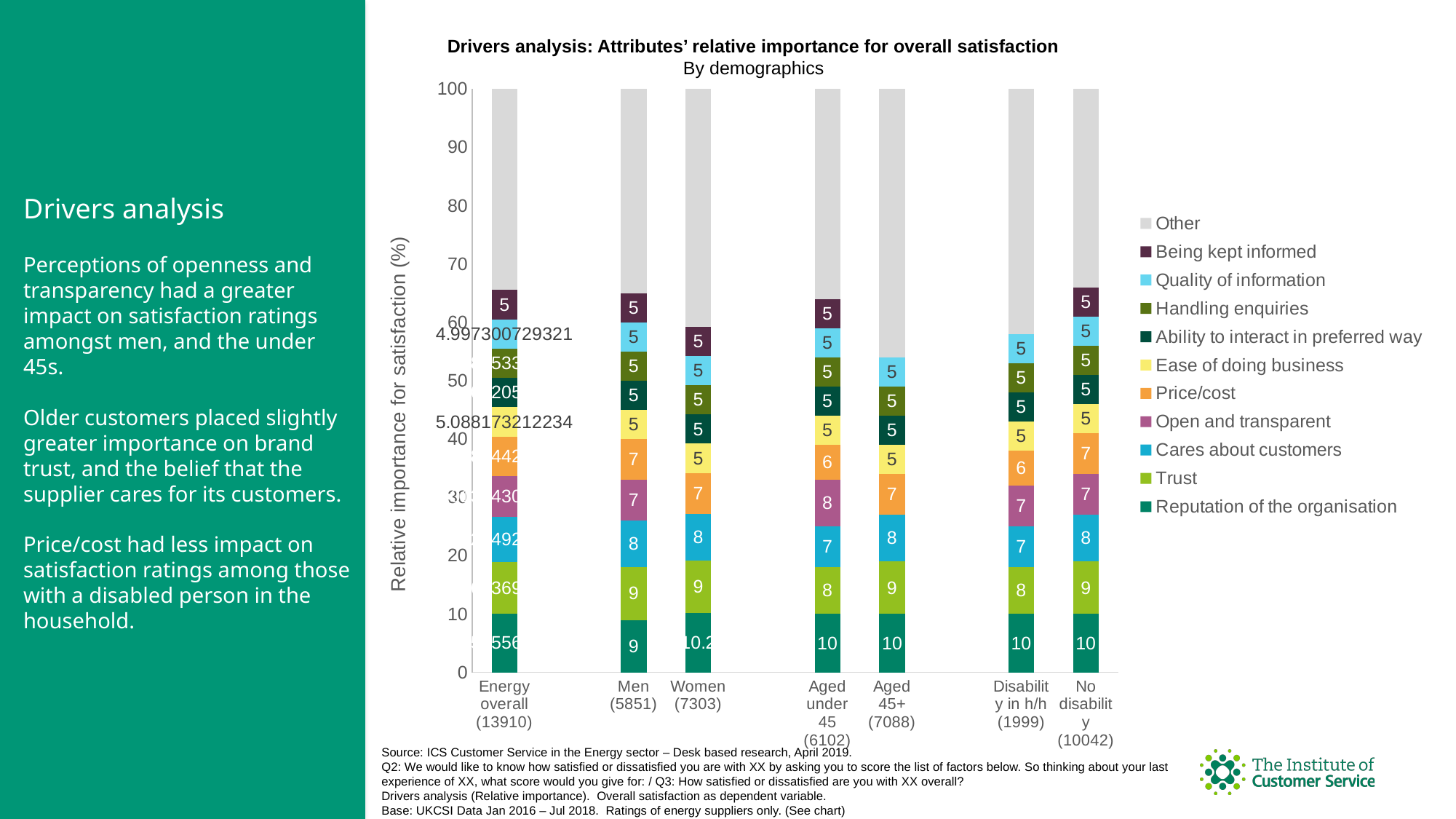
What is the value for Open and transparent for Aged under 45 (6102)? 8 What is the value for Reputation of the organisation for Men (5851)? 9 What is the value for Price/cost for Disability in h/h (1999)? 6 How many series does the legend list? 11 What is the difference between the Price/cost value for Men (5851) and for Disability in h/h (1999)? 1 What is the value for Trust for No disability (10042)? 9 What kind of chart is shown on the slide? Stacked bar chart Which legend entry is listed first (at the top) in the legend? Other Which has the larger Trust value, Men (5851) or Aged under 45 (6102)? Men (5851) What is the value for Cares about customers for Women (7303)? 8 What is the title of the chart? Drivers analysis: Attributes' relative importance for overall satisfaction How many demographic groups (bars) are plotted on the x axis? 7